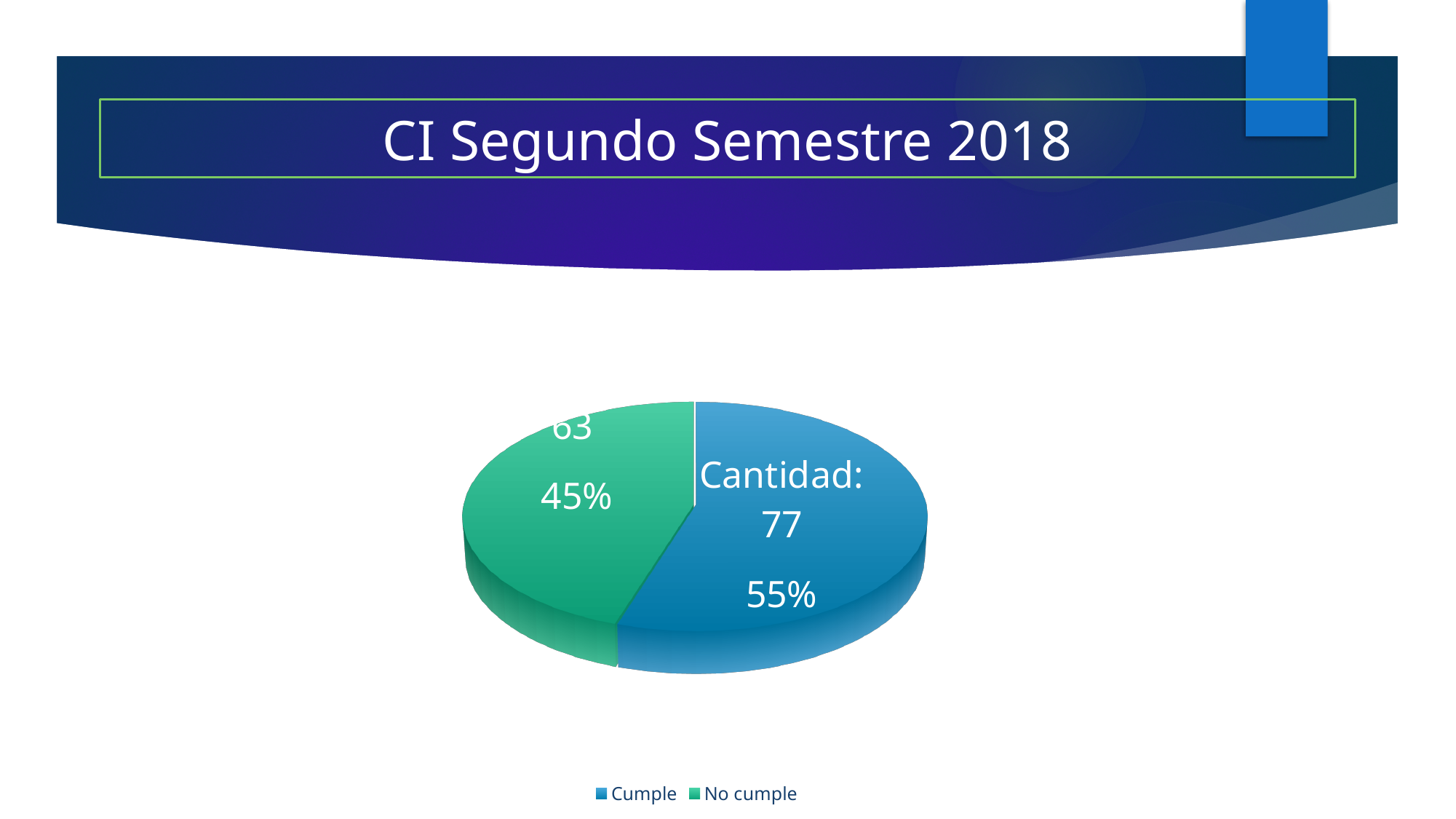
What percentage share does the No cumple slice have? 45% What is the value for No cumple? 63 Which is larger, Cumple or No cumple? Cumple What kind of chart is shown on the slide? pie chart How many slices does the pie chart have? 2 Which category has the largest slice? Cumple What colour is the Cumple slice? blue What percentage share does the Cumple slice have? 55% What is the title of the slide? CI Segundo Semestre 2018 Which category has the smallest slice? No cumple What is the value for Cumple? 77 What is the difference between the Cumple and No cumple values? 14